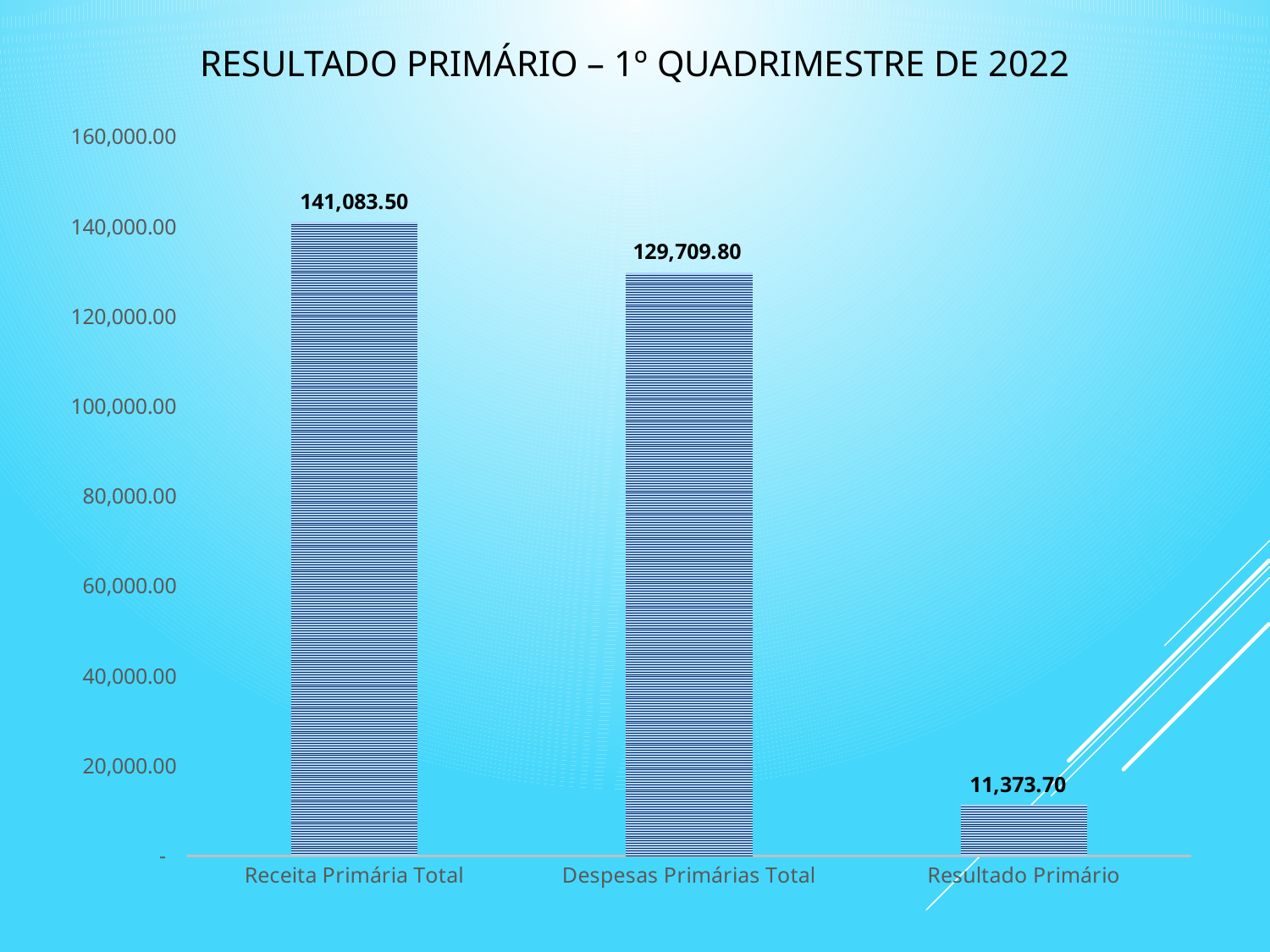
What is the value for Despesas Primárias Total? 129,709.80 What is the value for Resultado Primário? 11,373.70 What is the title of the chart? RESULTADO PRIMÁRIO – 1º QUADRIMESTRE DE 2022 Which is larger, Despesas Primárias Total or Resultado Primário? Despesas Primárias Total What is the difference between Receita Primária Total and Despesas Primárias Total? 11,373.70 What is the value for Receita Primária Total? 141,083.50 Which category has the highest value? Receita Primária Total What kind of chart is shown on the slide? Bar chart How many categories are shown on the chart? 3 Is the value for Resultado Primário greater or less than 20,000.00? less Which category has the lowest value? Resultado Primário Is the value for Despesas Primárias Total greater or less than 120,000.00? greater